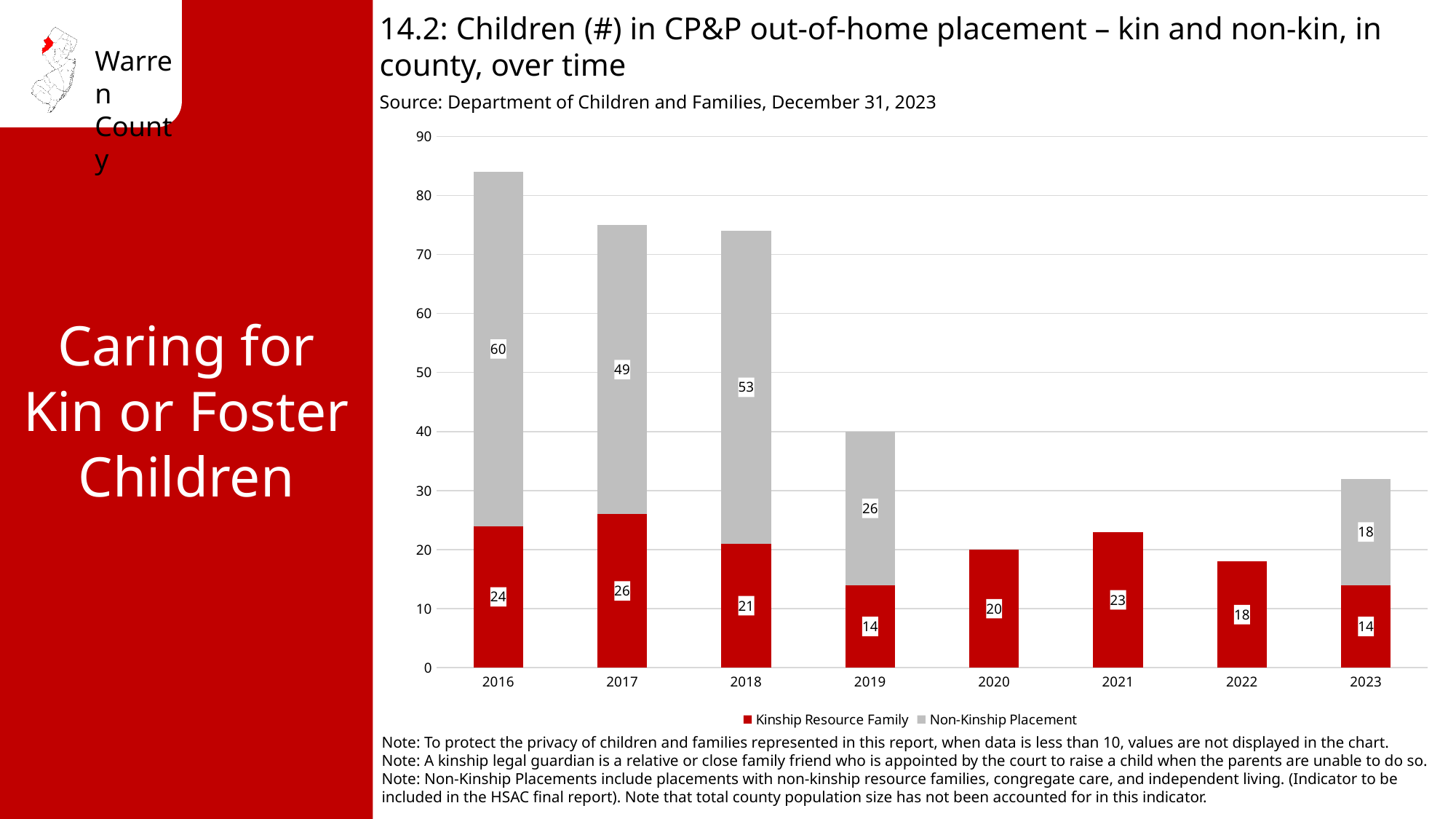
Which is larger, the Kinship Resource Family value for 2021 or for 2022? 2021 What is the Kinship Resource Family value for 2017? 26 What is the Non-Kinship Placement value for 2023? 18 Is the total of the stacked bar for 2019 greater or less than 50? less What is the Non-Kinship Placement value for 2018? 53 What is the total of the stacked bar for 2016? 84 How many series does the legend list? 2 Which year has the highest Non-Kinship Placement value? 2016 How many years are shown on the x axis? 8 What is the difference between the Non-Kinship Placement values for 2016 and 2017? 11 Which year has the highest Kinship Resource Family value? 2017 What kind of chart is shown on the slide? Stacked bar chart